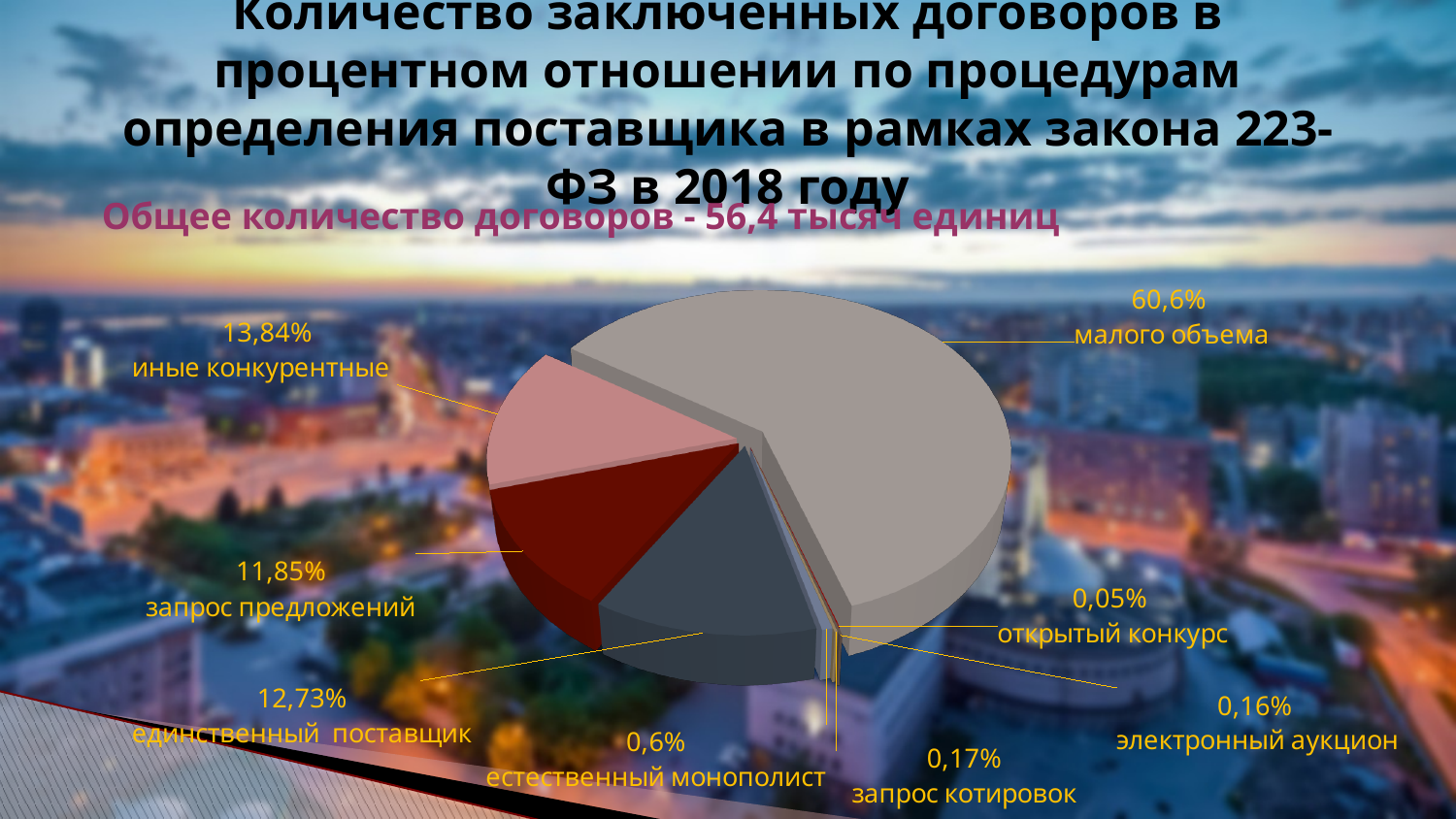
What is the difference between the shares for "единственный поставщик" and "запрос предложений"? 0,88% Which category has the largest share of the pie? малого объема How many categories (slices) does the pie chart have? 8 What percentage is shown for "единственный поставщик"? 12,73% What percentage is shown for "иные конкурентные"? 13,84% What percentage is shown for "открытый конкурс"? 0,05% Which category has the smallest share of the pie? открытый конкурс What type of chart is shown on the slide? Pie chart What share of contracts is labelled for "малого объема"? 60,6% What percentage is shown for "запрос предложений"? 11,85% Which is larger: the share for "иные конкурентные" or for "запрос предложений"? иные конкурентные According to the subtitle, what is the total number of contracts? 56,4 тысяч единиц